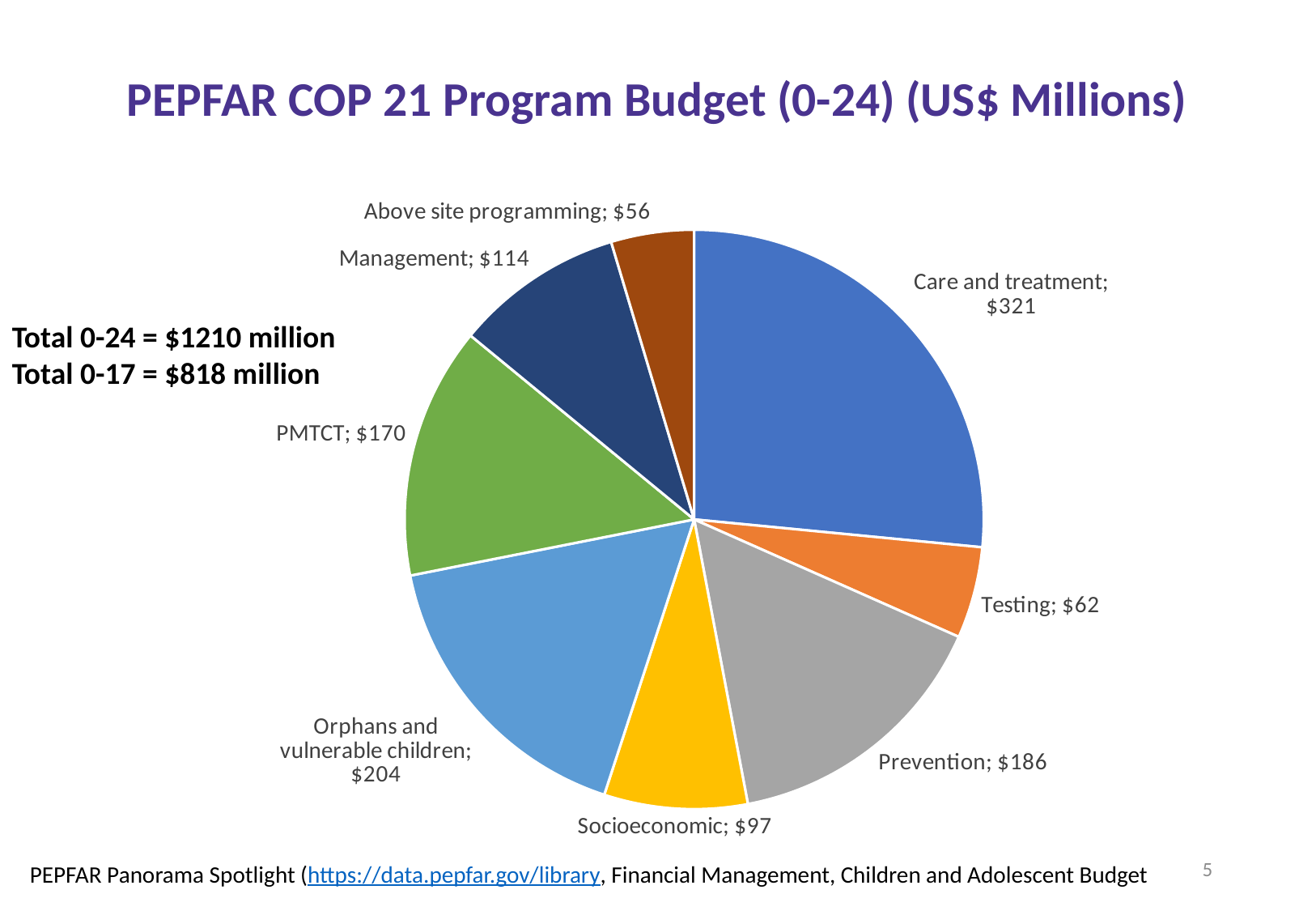
What is the budget value for PMTCT in the pie chart? $170 Which category has the smallest slice of the pie chart? Above site programming What is the title of the chart on the slide? PEPFAR COP 21 Program Budget (0-24) (US$ Millions) Which category has the largest slice of the pie chart? Care and treatment Which is larger, the Socioeconomic slice or the Management slice? Management What type of chart is shown on the slide? Pie chart What is the budget value for Orphans and vulnerable children? $204 What is the difference between the Care and treatment and Management budget values? $207 What is the difference between the Prevention and Testing budget values? $124 What is the budget value for Care and treatment in the pie chart? $321 What share of the total $1210 million does Care and treatment represent? 26.5% How many categories are shown in the pie chart? 8